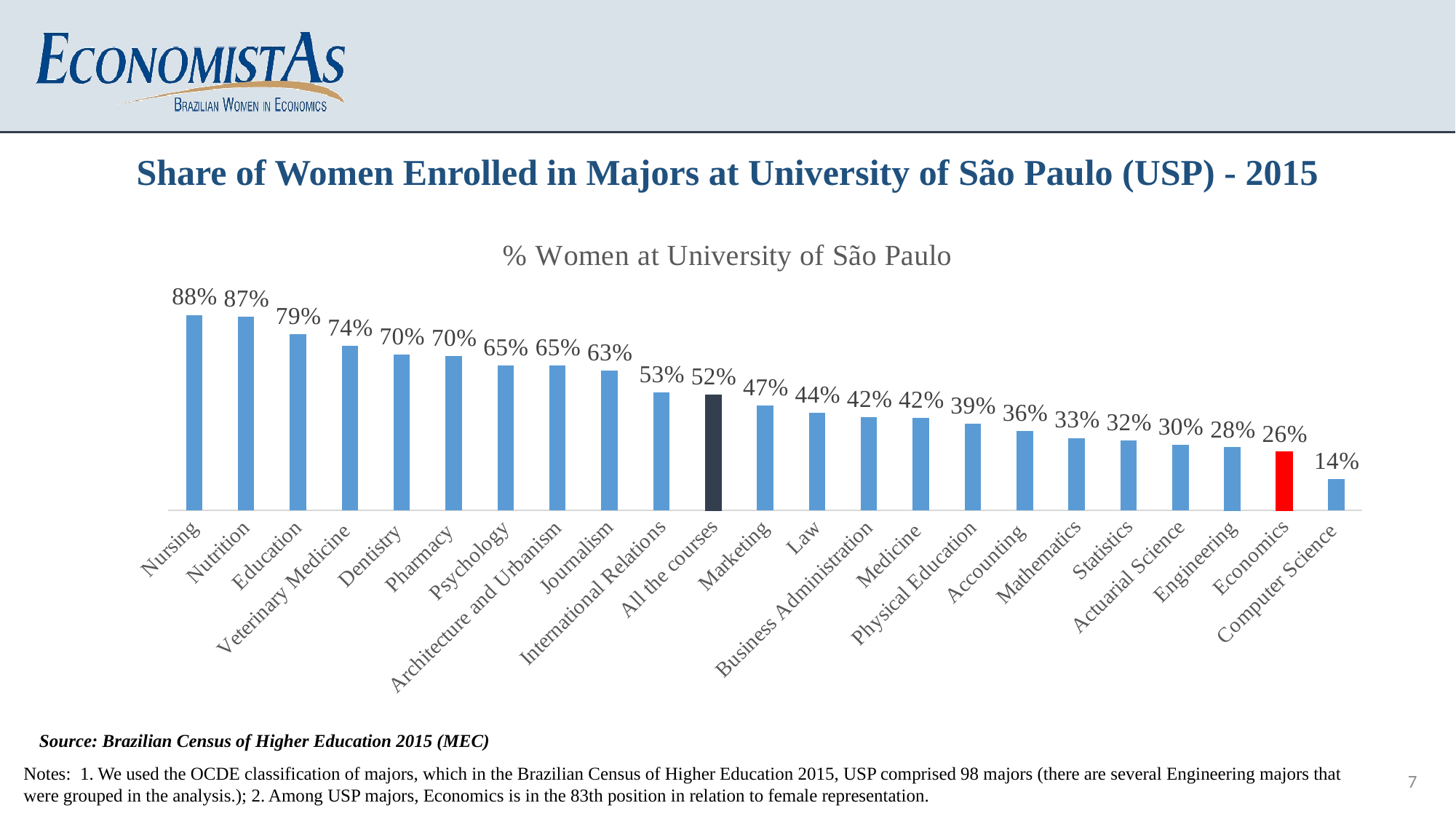
What is the value for Economics? 26% What is the value for All the courses? 52% Do the values rise or fall from left to right along the x axis? Fall How many categories are shown on the x axis? 23 What is the difference between the values for All the courses and Economics? 26% Which category has the highest value? Nursing What is the difference between the values for Nursing and Computer Science? 74% What kind of chart is shown on the slide? Bar chart Which category has the lowest value? Computer Science What is the value for Veterinary Medicine? 74% What is the title of the chart? % Women at University of São Paulo Which is larger, the value for Law or the value for Medicine? Law